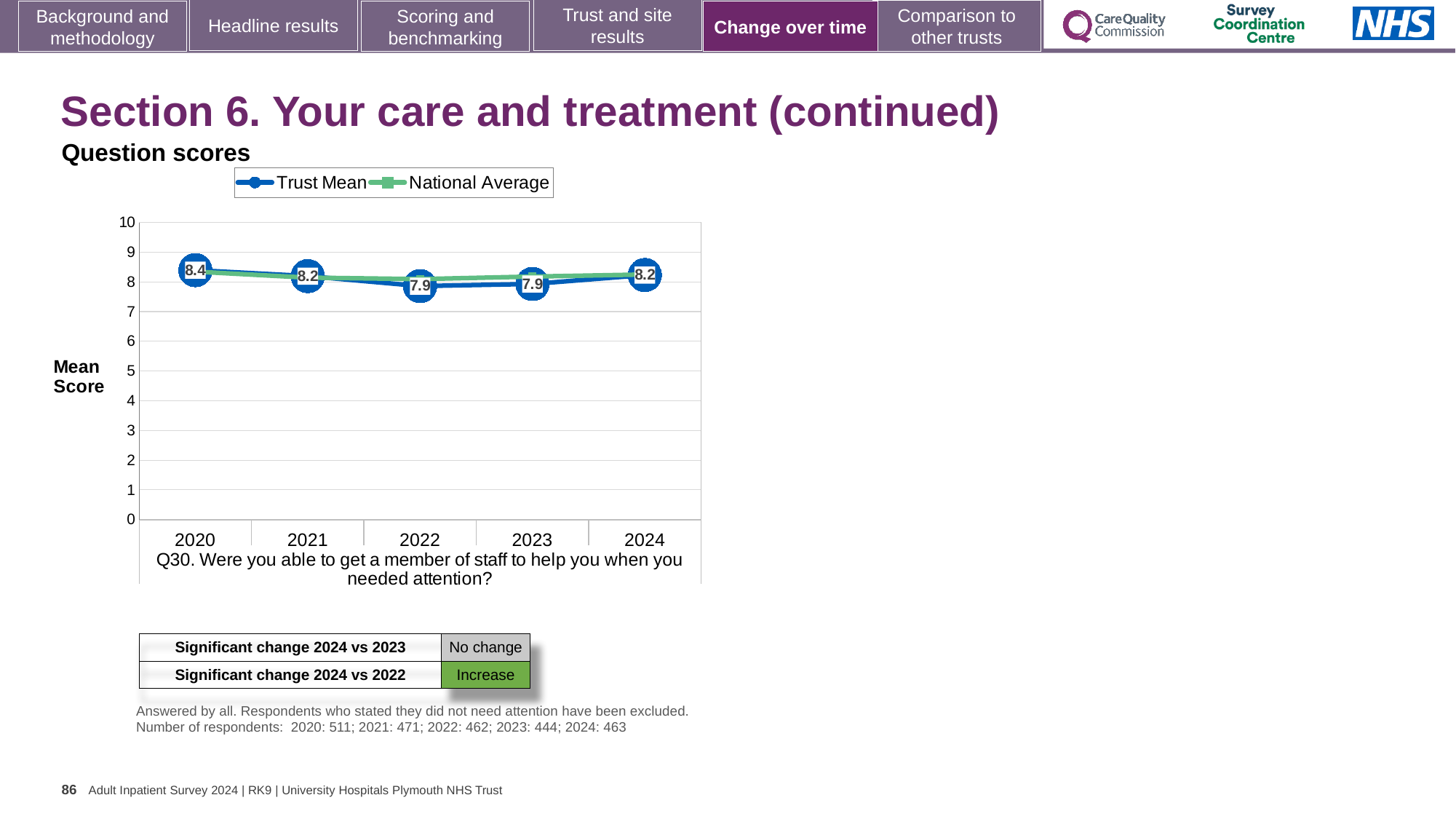
In which year is the Trust Mean score highest? 2020 What is the Trust Mean score for 2020? 8.4 What kind of chart is shown on the slide? line chart How many series does the legend list? 2 What is the difference between the Trust Mean score in 2020 and in 2022? 0.5 How many years are plotted on the x axis? 5 What is the lowest Trust Mean score shown on the chart? 7.9 What is the Trust Mean score for 2024? 8.2 Does the Trust Mean score rise or fall from 2020 to 2022? fall Is the Trust Mean score for 2021 greater or less than 7? greater Which year has the larger Trust Mean score, 2020 or 2024? 2020 What is the Trust Mean score for 2022? 7.9